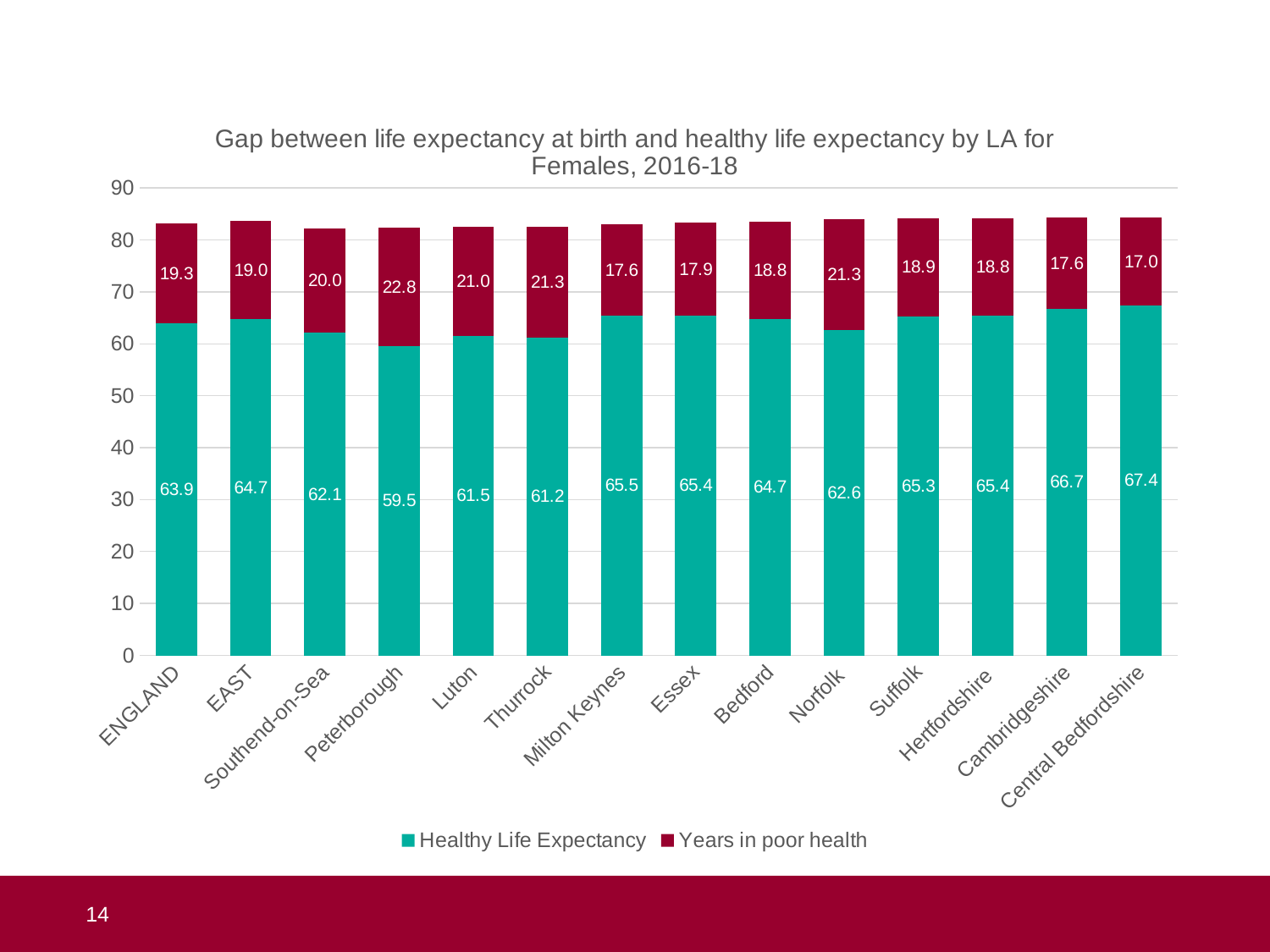
Which local authority has the highest Healthy Life Expectancy? Central Bedfordshire Which local authority has the lowest Healthy Life Expectancy? Peterborough What is the total of the stacked bar for Central Bedfordshire? 84.4 What is the Healthy Life Expectancy value for Peterborough? 59.5 Which has a higher Years in poor health value, Luton or Essex? Luton What is the total of the stacked bar for Peterborough? 82.3 What is the Years in poor health value for Norfolk? 21.3 Which category has the highest Years in poor health value? Peterborough What is the difference between the Healthy Life Expectancy for Central Bedfordshire and for ENGLAND? 3.5 How many series does the legend list? 2 What type of chart is shown on the slide? Stacked bar chart How many local authorities or areas are shown on the x axis? 14